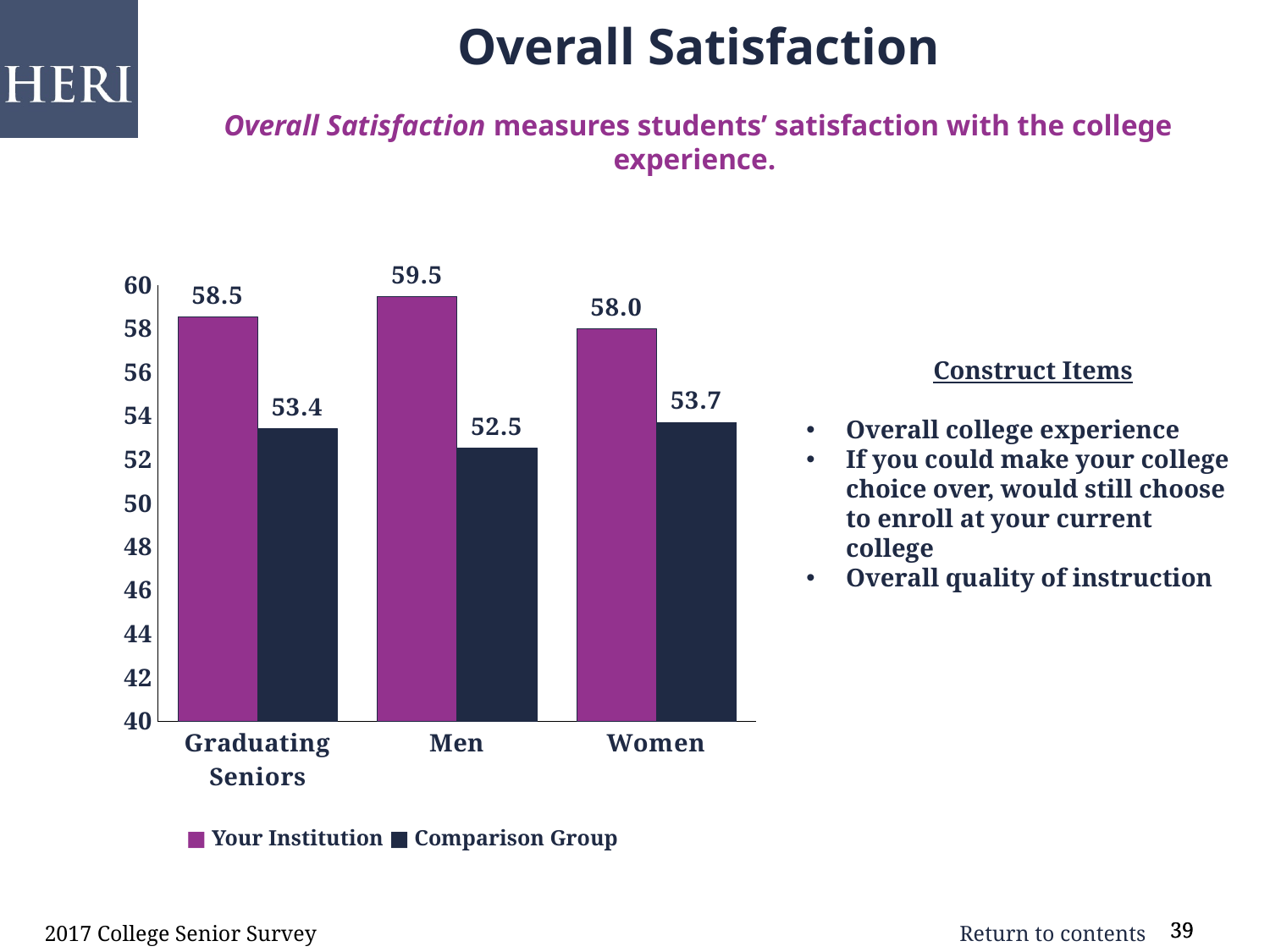
What is the Comparison Group value for Women? 53.7 What kind of chart is shown on the slide? bar chart Which category has the highest Your Institution value? Men Which is larger for Men: the Your Institution value or the Comparison Group value? Your Institution How many series does the legend list? 2 What is the Your Institution value for Men? 59.5 How many categories are shown on the x axis? 3 What is the difference between the Your Institution and Comparison Group values for Graduating Seniors? 5.1 What is the Comparison Group value for Graduating Seniors? 53.4 Which category has the lowest Comparison Group value? Men Is the Comparison Group value for Men greater or less than 54? less What is the Your Institution value for Women? 58.0